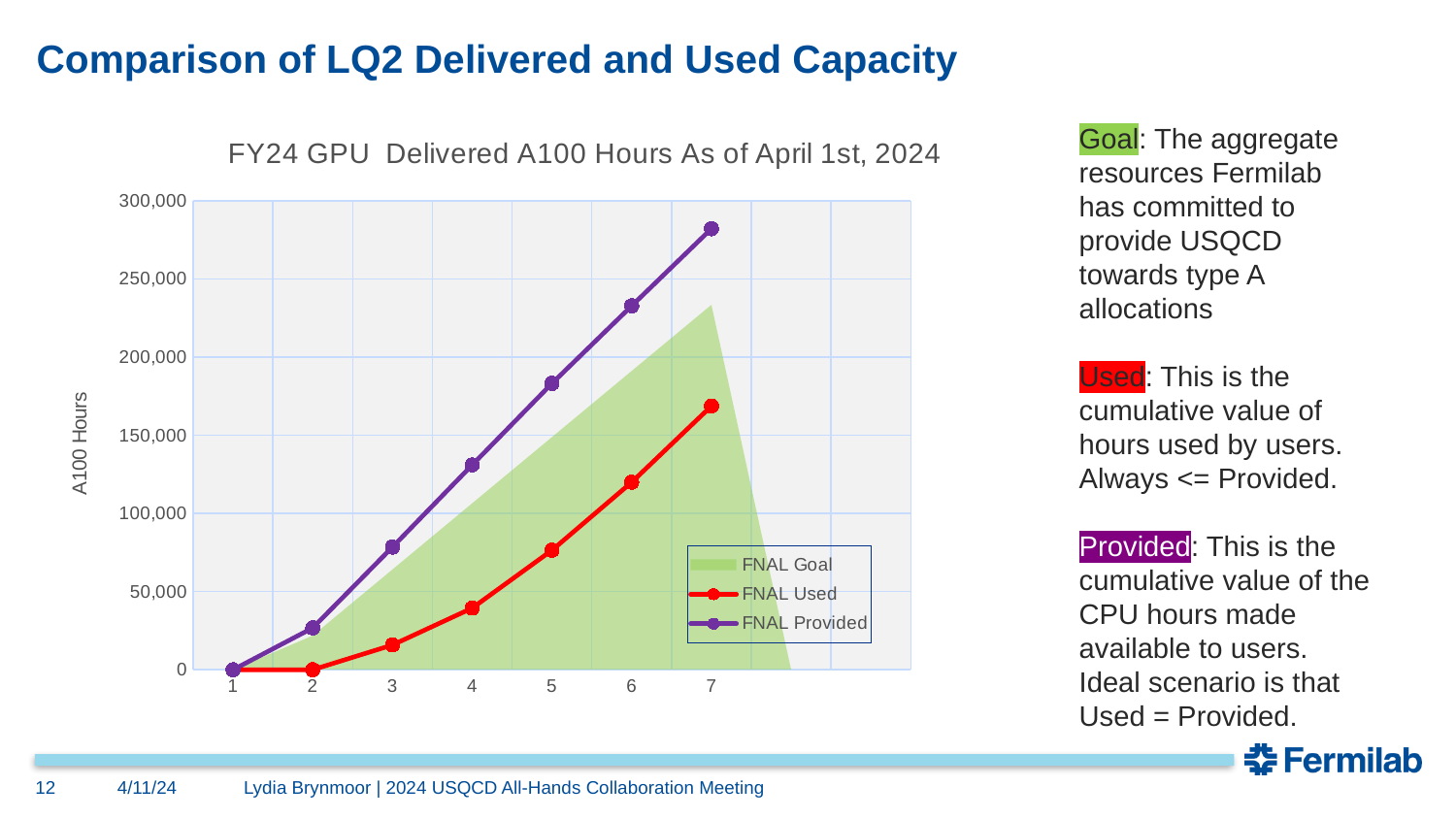
What is the label on the y axis? A100 Hours How many points are plotted along the x axis for the FNAL Provided series? 7 Is the value for FNAL Provided at x = 7 greater or less than 250,000? greater What is the title of the chart? FY24 GPU Delivered A100 Hours As of April 1st, 2024 At x = 7, which series has the larger value, FNAL Used or FNAL Provided? FNAL Provided How many series does the chart legend list? 3 Is the value for FNAL Used at x = 7 greater or less than 200,000? less Do the FNAL Provided values rise or fall from x = 1 to x = 7? rise Is the value for FNAL Used at x = 4 greater or less than 50,000? less What kind of chart is shown on the slide? combination area and line chart